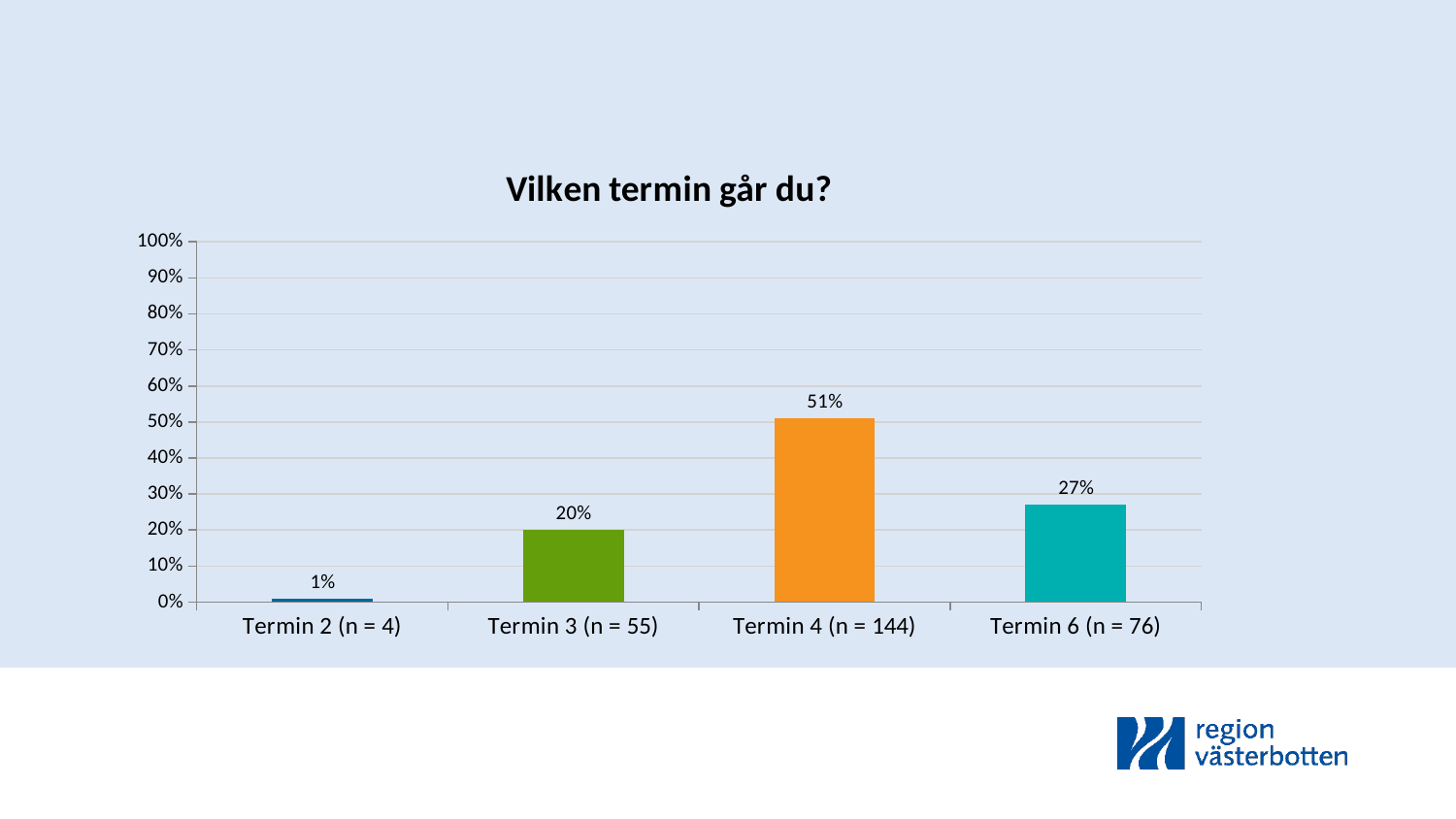
How many categories are shown on the x axis? 4 What is the title of the chart? Vilken termin går du? Which category has the lowest value? Termin 2 (n = 4) Which category has the highest value? Termin 4 (n = 144) What is the value for Termin 4 (n = 144)? 51% Is the value for Termin 4 (n = 144) greater or less than 50%? greater What is the value for Termin 2 (n = 4)? 1% What is the value for Termin 3 (n = 55)? 20% What kind of chart is shown on the slide? bar chart What is the value for Termin 6 (n = 76)? 27% What is the difference between the values for Termin 4 (n = 144) and Termin 6 (n = 76)? 24% Which is larger, the value for Termin 3 (n = 55) or Termin 6 (n = 76)? Termin 6 (n = 76)